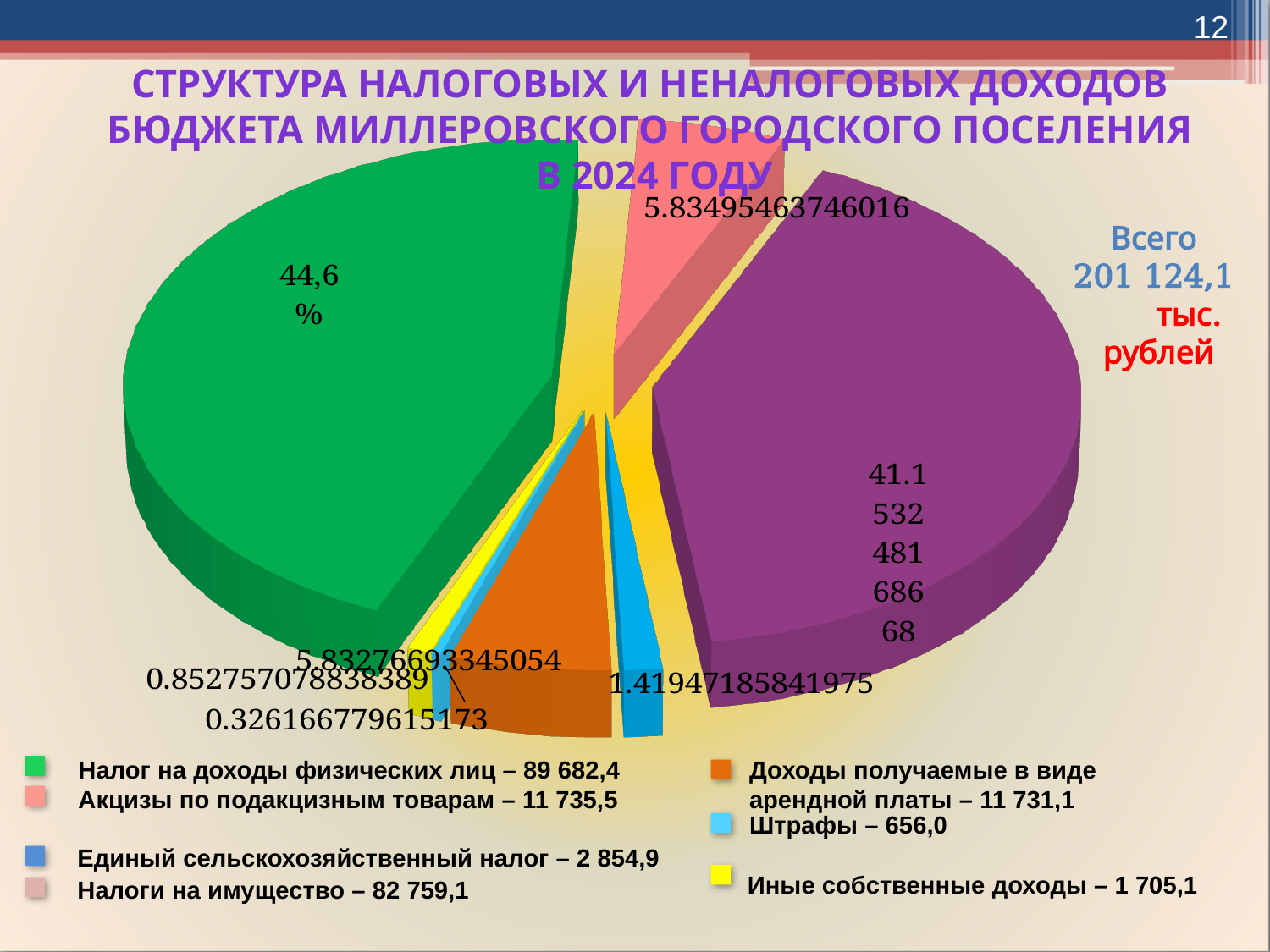
Which category has the highest value? Налог на доходы физических лиц What is the value for Единый сельскохозяйственный налог? 2 854,9 What percentage share is labelled on the largest (green) slice? 44,6 % Which category has the lowest value? Штрафы What kind of chart is shown on the slide? pie chart What is the value for Акцизы по подакцизным товарам? 11 735,5 What is the difference between Налог на доходы физических лиц and Налоги на имущество? 6 923,3 What is the value for Иные собственные доходы? 1 705,1 What total amount (Всего) is stated on the slide? 201 124,1 тыс. рублей How many categories are listed in the legend? 7 What is the value for Штрафы? 656,0 What is the value for Налог на доходы физических лиц? 89 682,4